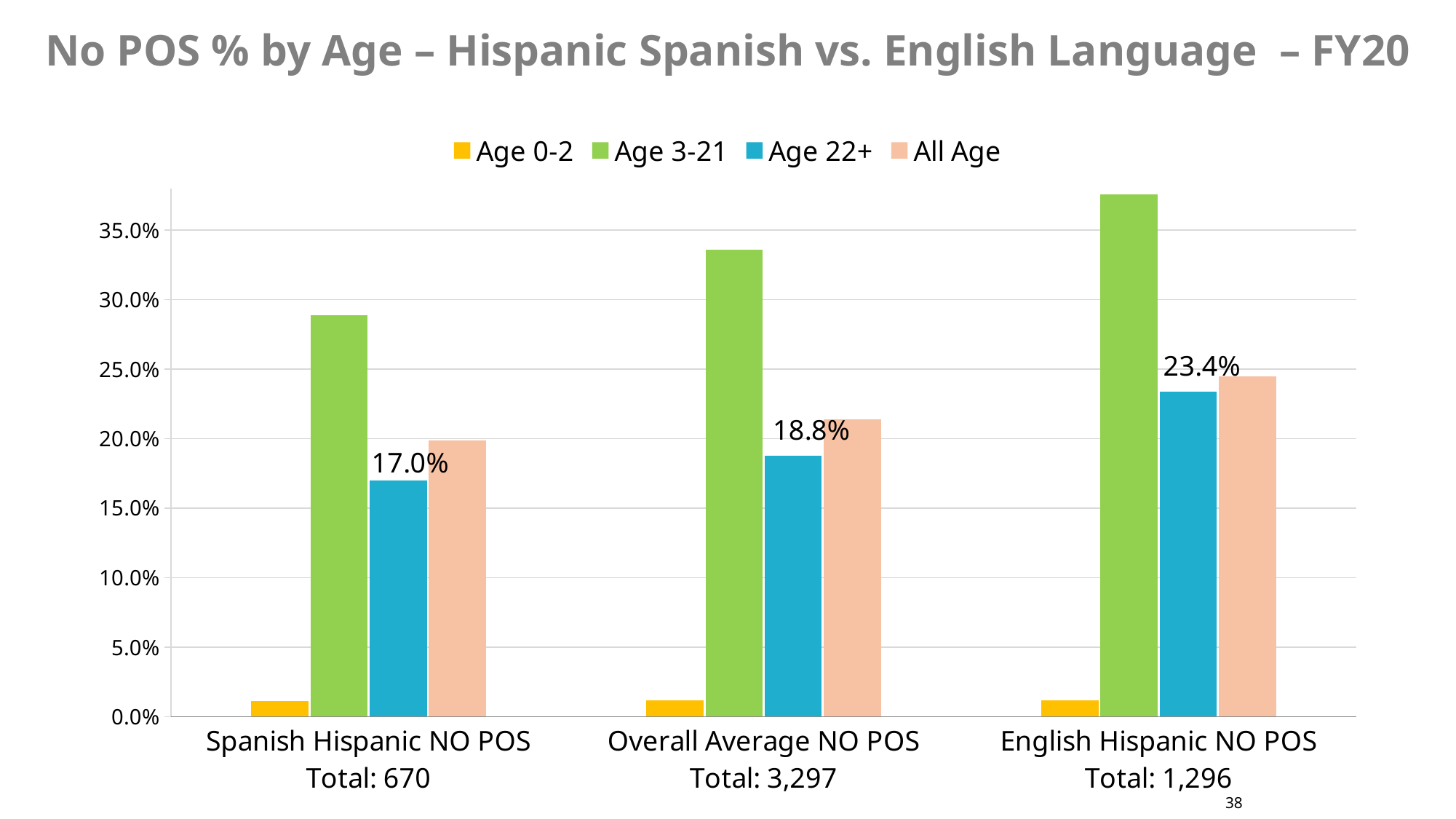
What is the difference between the Age 22+ values for English Hispanic NO POS and Spanish Hispanic NO POS? 6.4% What is the Age 22+ value for English Hispanic NO POS? 23.4% How many series does the legend list? 4 How many categories are shown on the x axis? 3 Which category has the lowest Age 22+ value? Spanish Hispanic NO POS What is the Age 22+ value for Overall Average NO POS? 18.8% What kind of chart is shown on the slide? Bar chart Which is larger for Overall Average NO POS: the Age 3-21 value or the All Age value? Age 3-21 Is the Age 3-21 value for Spanish Hispanic NO POS greater or less than 30.0%? less Which category has the highest Age 22+ value? English Hispanic NO POS Is the Age 3-21 value for English Hispanic NO POS greater or less than 35.0%? greater What is the Age 22+ value for Spanish Hispanic NO POS? 17.0%